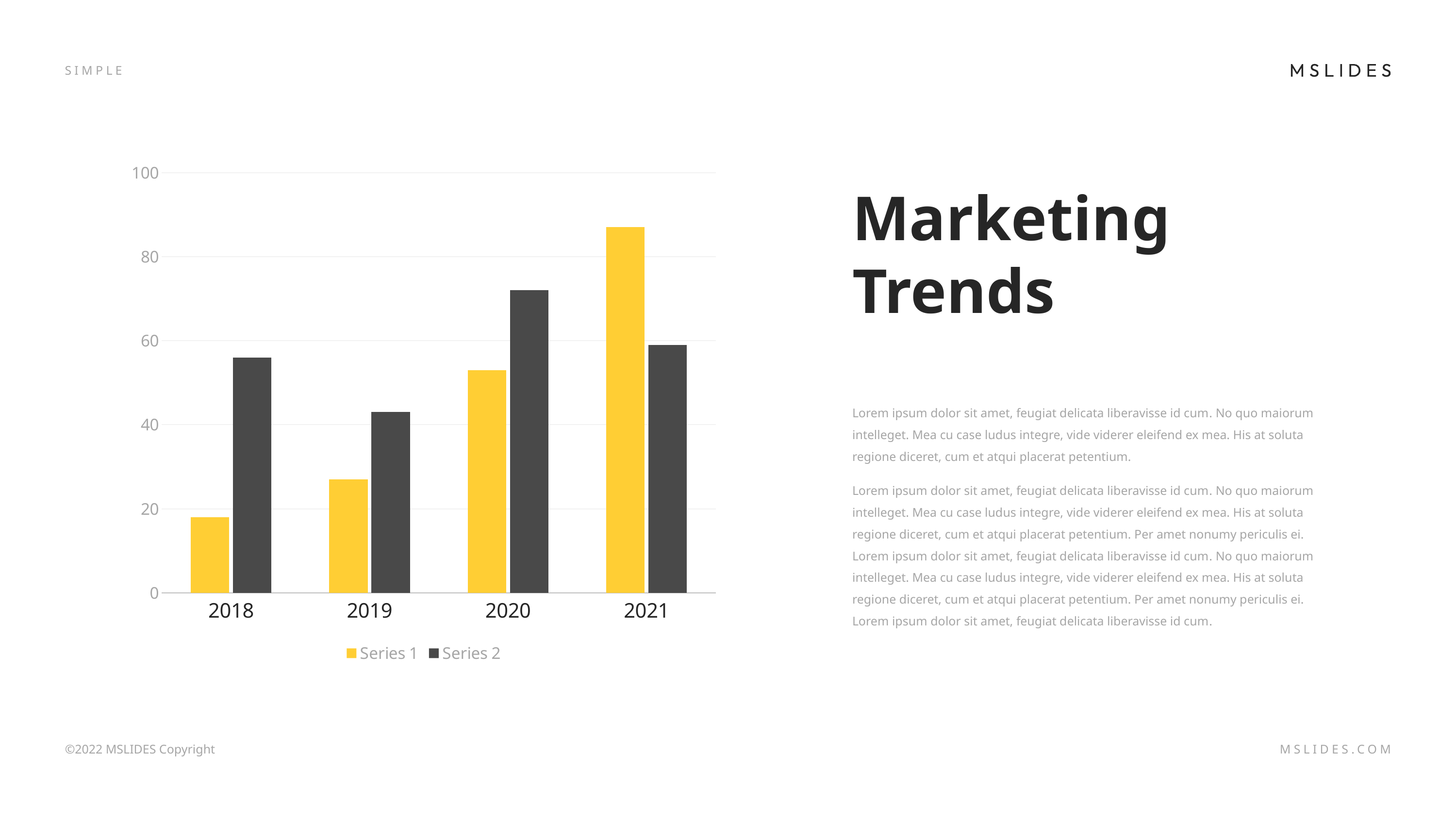
Is the value for Series 1 in 2018 greater or less than 20? less Which year has the lowest value for Series 1? 2018 Which year has the highest value for Series 1? 2021 How many years are shown on the x axis? 4 In 2019, which is larger, Series 1 or Series 2? Series 2 What kind of chart is shown on the slide? bar chart Is the value for Series 1 in 2021 greater or less than 80? greater Is the value for Series 2 in 2020 greater or less than 60? greater Which year has the highest value for Series 2? 2020 Which year has the lowest value for Series 2? 2019 Do the Series 1 values rise or fall from 2018 to 2021? rise How many series does the legend list? 2